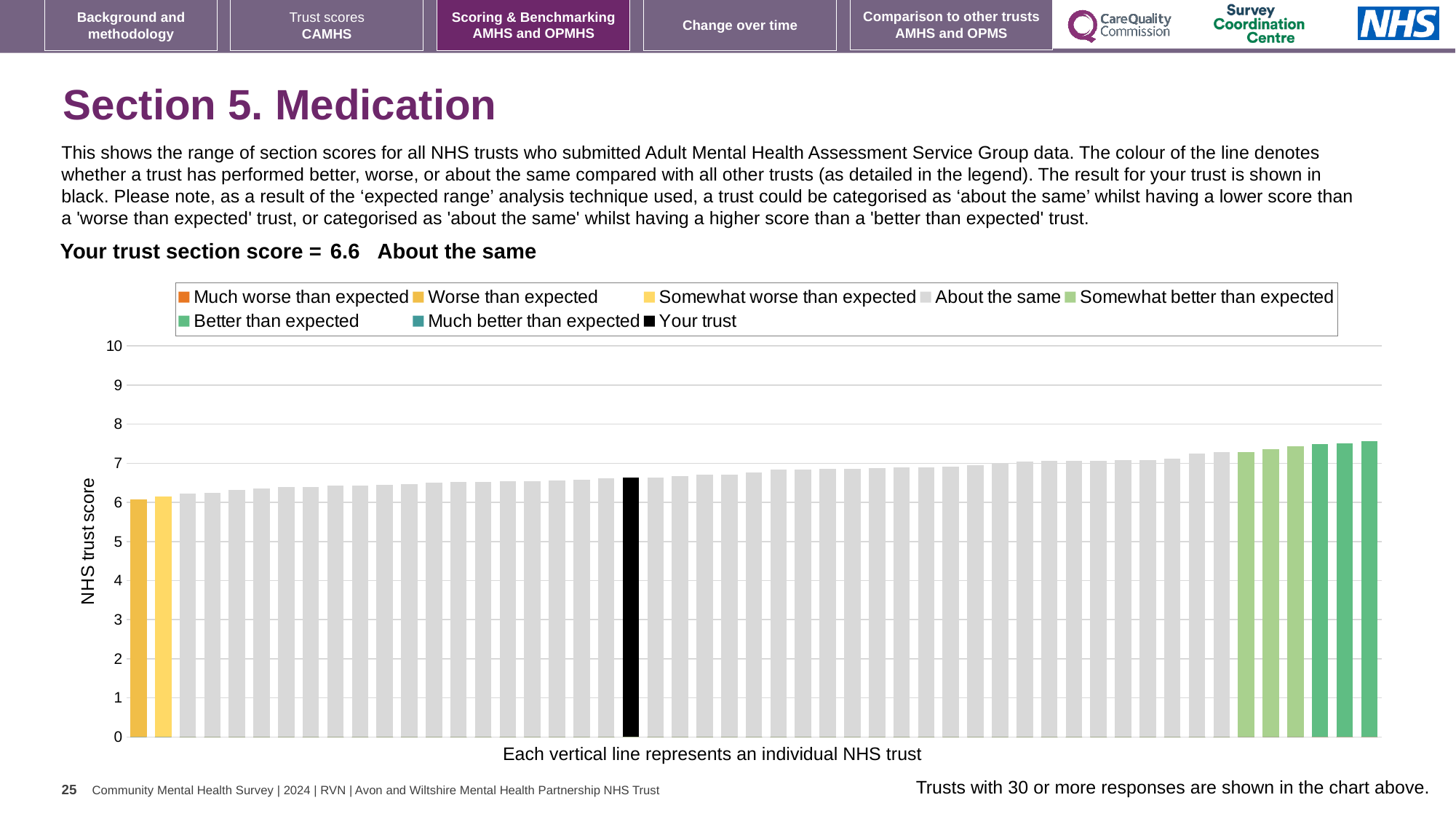
What is the section score for your trust? 6.6 What kind of chart is shown on the slide? bar chart Which is larger: the bar for your trust or the leftmost bar? Your trust Is the value for your trust greater or less than 5? greater Is the value for your trust greater or less than 7? less Is the value of the highest bar greater or less than 8? less Do the bar values rise or fall from left to right along the x axis? rise What is the label on the vertical axis of the chart? NHS trust score How many entries does the chart legend list? 8 Which category is your trust's section score placed in? About the same